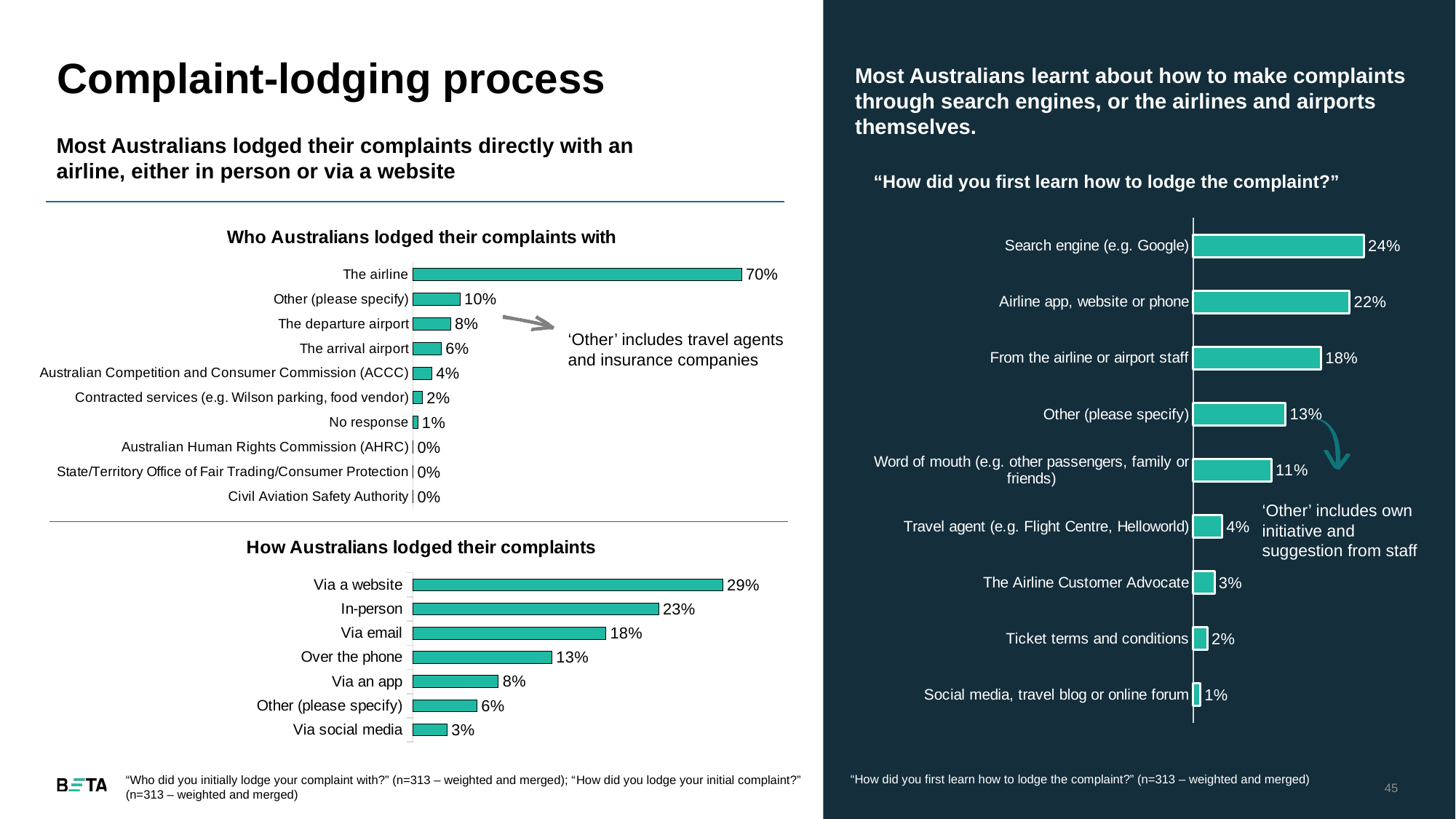
What type of chart is the 'How Australians lodged their complaints' chart? Bar chart In the 'Who Australians lodged their complaints with' chart, what is the difference between The airline and Other (please specify)? 60% In the 'How Australians lodged their complaints' chart, what is the value for Over the phone? 13% In the chart on the right ('How did you first learn how to lodge the complaint?'), what is the difference between Airline app, website or phone and From the airline or airport staff? 4% In the 'How Australians lodged their complaints' chart, which category has the highest value? Via a website In the chart on the right ('How did you first learn how to lodge the complaint?'), how many categories are shown? 9 In the 'Who Australians lodged their complaints with' chart, how many categories are shown? 10 In the 'Who Australians lodged their complaints with' chart, what is the value for The airline? 70% In the 'How Australians lodged their complaints' chart, which is larger: In-person or Via email? In-person In the 'How Australians lodged their complaints' chart, which category has the lowest value? Via social media In the chart on the right ('How did you first learn how to lodge the complaint?'), what is the value for Search engine (e.g. Google)? 24% In the 'Who Australians lodged their complaints with' chart, what is the value for The departure airport? 8%